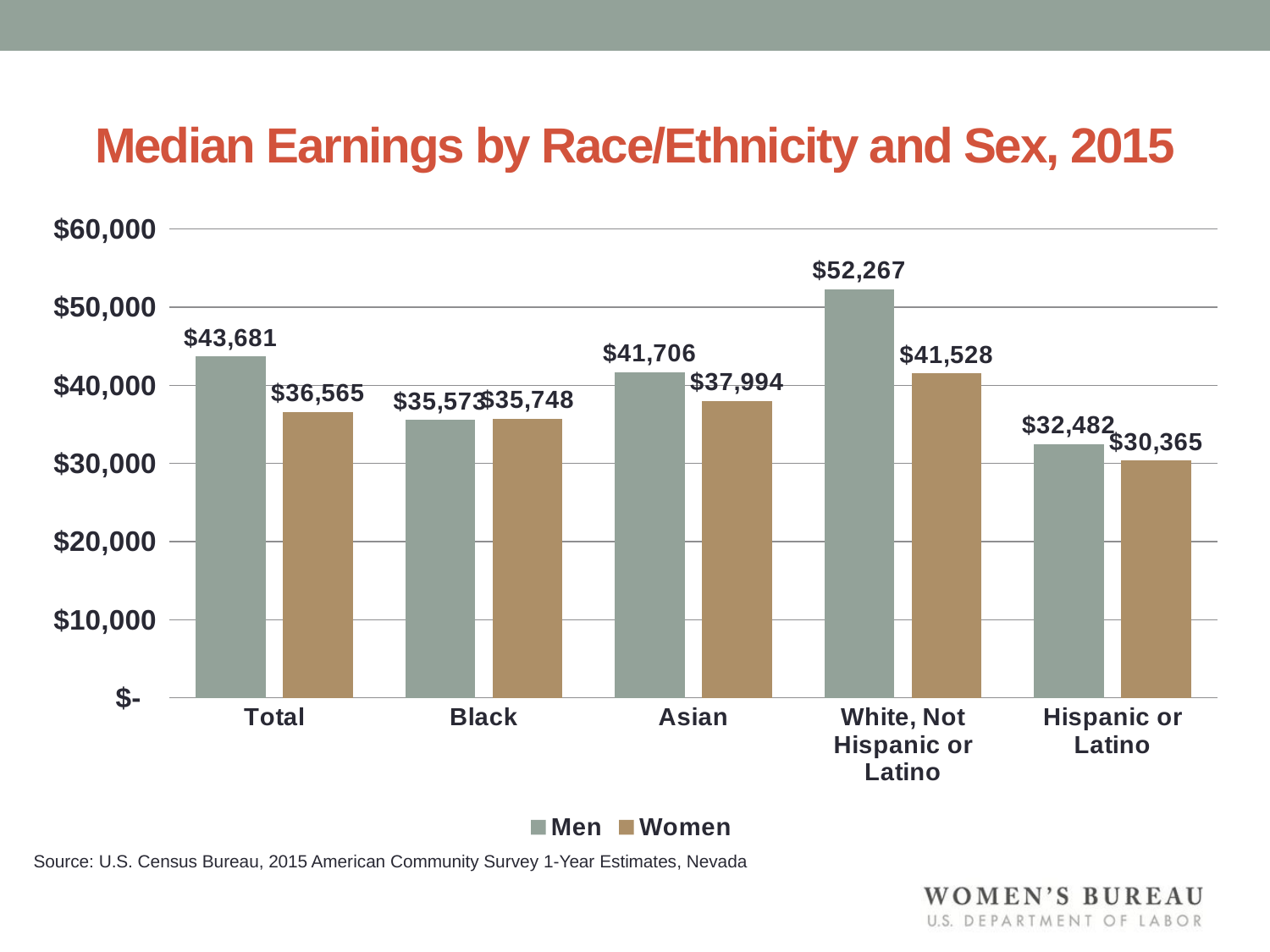
How many race/ethnicity categories are shown on the x axis? 5 What is the median earnings value for Men in the White, Not Hispanic or Latino category? $52,267 What kind of chart is shown on the slide? Bar chart What is the median earnings value for Men in the Asian category? $41,706 What is the difference between Men's and Women's median earnings in the Total category? $7,116 What is the median earnings value for Women in the Hispanic or Latino category? $30,365 What is the median earnings value for Women in the Total category? $36,565 Which race/ethnicity category has the highest median earnings for Men? White, Not Hispanic or Latino Which race/ethnicity category has the lowest median earnings for Women? Hispanic or Latino How many series does the legend list? 2 Which is larger: Women's median earnings for Asian or Women's median earnings for Total? Asian What is the difference between Men's and Women's median earnings in the White, Not Hispanic or Latino category? $10,739